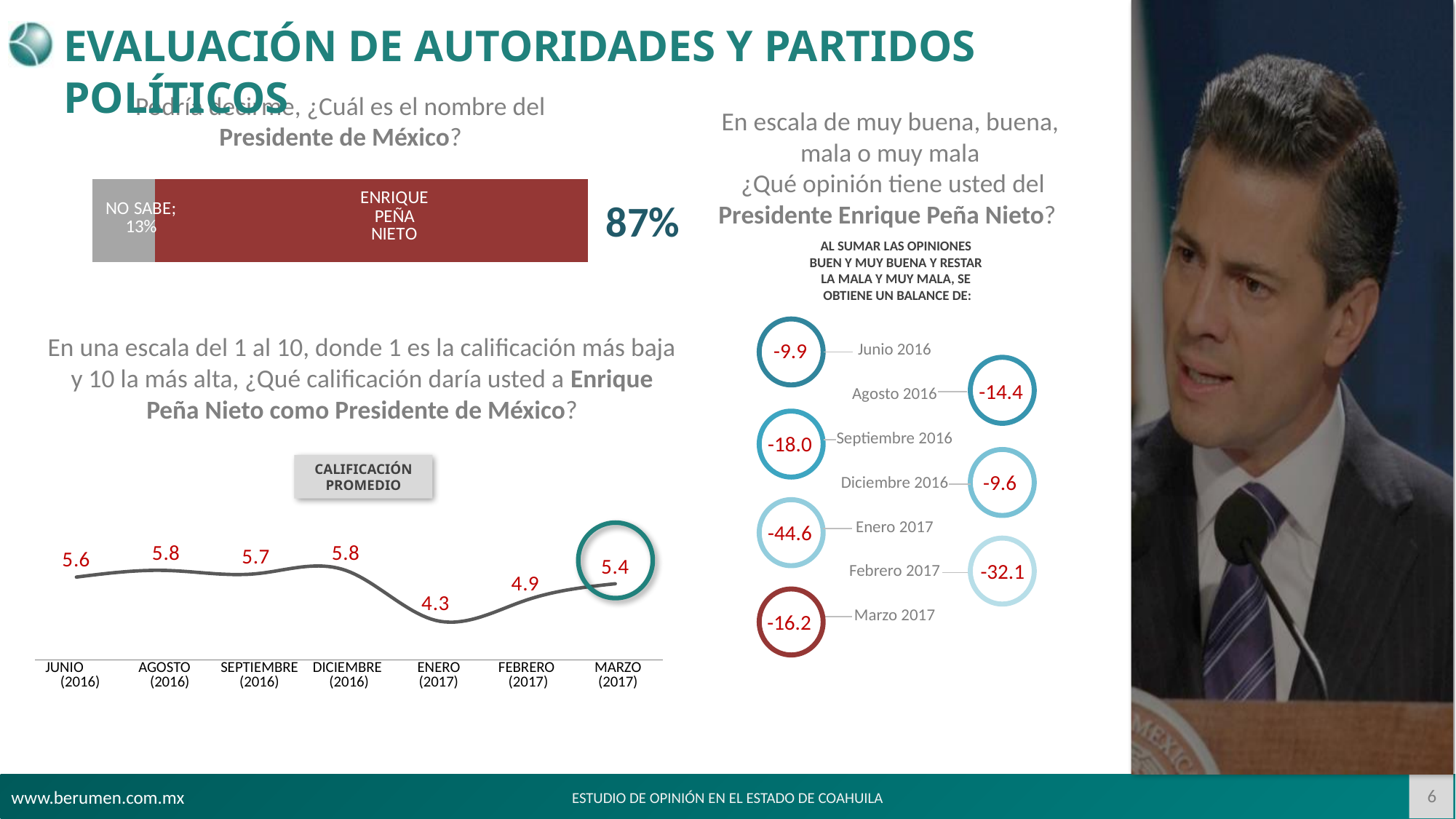
In the line chart of the average rating for Enrique Peña Nieto, do the values rise or fall from ENERO (2017) to MARZO (2017)? rise In the line chart of the average rating for Enrique Peña Nieto, what is the value for MARZO (2017)? 5.4 How many months are plotted in the line chart of the average rating for Enrique Peña Nieto? 7 In the bar chart about the name of the President of Mexico, what percentage answered ENRIQUE PEÑA NIETO? 87% In the line chart of the average rating for Enrique Peña Nieto, what is the difference between the values for DICIEMBRE (2016) and ENERO (2017)? 1.5 What kind of chart shows the average rating (calificación promedio) for Enrique Peña Nieto over time? line chart What kind of chart shows the responses about the name of the President of Mexico? bar chart In the bar chart about the name of the President of Mexico, what is the total of the two segments? 100% In the line chart of the average rating (calificación promedio) for Enrique Peña Nieto, what is the value for ENERO (2017)? 4.3 In the bar chart about the name of the President of Mexico, what percentage is NO SABE? 13% In the line chart of the average rating for Enrique Peña Nieto, which is larger, the value for JUNIO (2016) or the value for FEBRERO (2017)? JUNIO (2016) In the line chart of the average rating for Enrique Peña Nieto, which month has the lowest value? ENERO (2017)